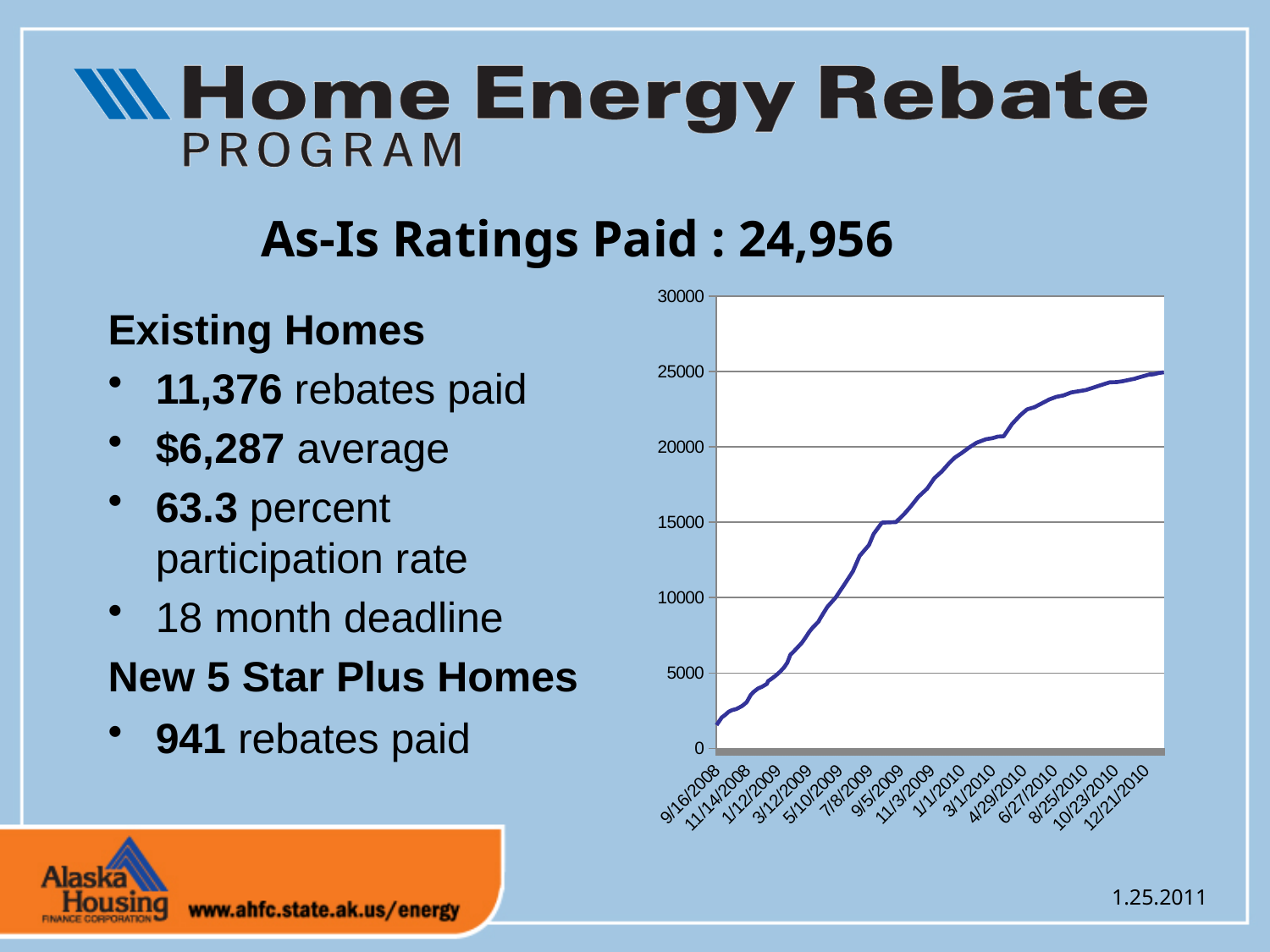
Do the values in the chart rise or fall from 9/16/2008 to 12/21/2010? rise Is the value for 11/14/2008 greater or less than 5000? less Is the value for 12/21/2010 greater or less than 20000? greater Is the value for 9/16/2008 greater or less than 5000? less What kind of chart is shown on the slide? line chart Which is larger, the value for 3/1/2010 or the value for 5/10/2009? 3/1/2010 Which date label on the x axis has the lowest value? 9/16/2008 Which date label on the x axis has the highest value? 12/21/2010 How many date labels are shown on the x axis of the chart? 15